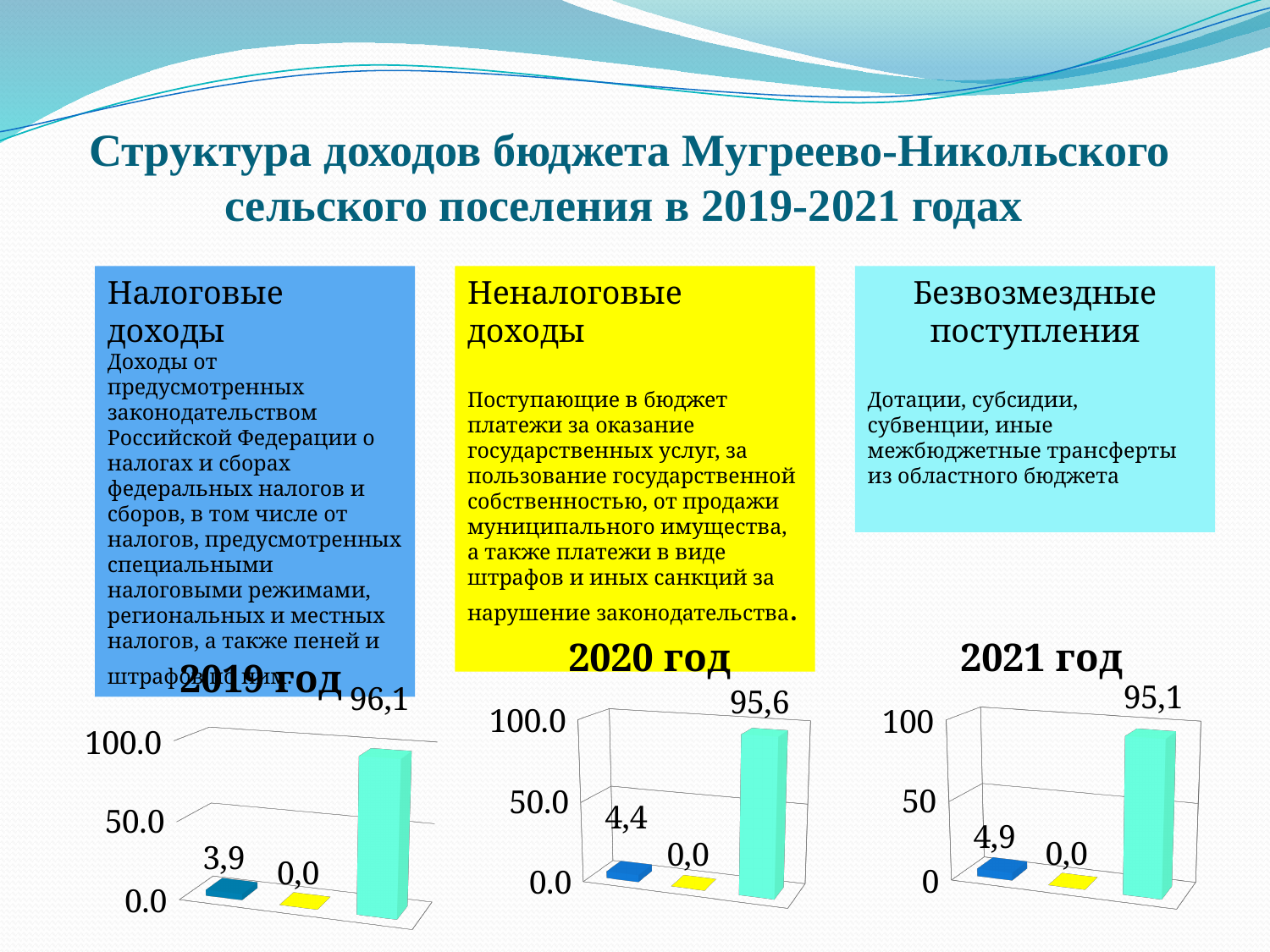
On the chart titled "2021 год", what is the difference between the cyan bar and the blue bar? 90,2 On the chart titled "2021 год", what value is labelled on the cyan bar? 95,1 On the chart titled "2020 год", which bar has the highest value? the cyan bar (95,6) On the chart titled "2021 год", what value is labelled on the yellow bar? 0,0 On the chart titled "2019 год", what value is labelled on the tallest (cyan) bar? 96,1 On the chart titled "2020 год", is the value of the cyan bar greater or less than 50.0? greater On the chart titled "2020 год", what value is labelled on the blue bar? 4,4 How many bars are plotted on the chart titled "2019 год"? 3 On the chart titled "2019 год", which bar has the lowest value? the yellow bar (0,0) Is the blue bar on the chart titled "2020 год" larger or smaller than the blue bar on the chart titled "2021 год"? smaller On the chart titled "2019 год", what is the difference between the cyan bar (96,1) and the blue bar (3,9)? 92,2 What kind of chart is used for the "2021 год" data? bar chart